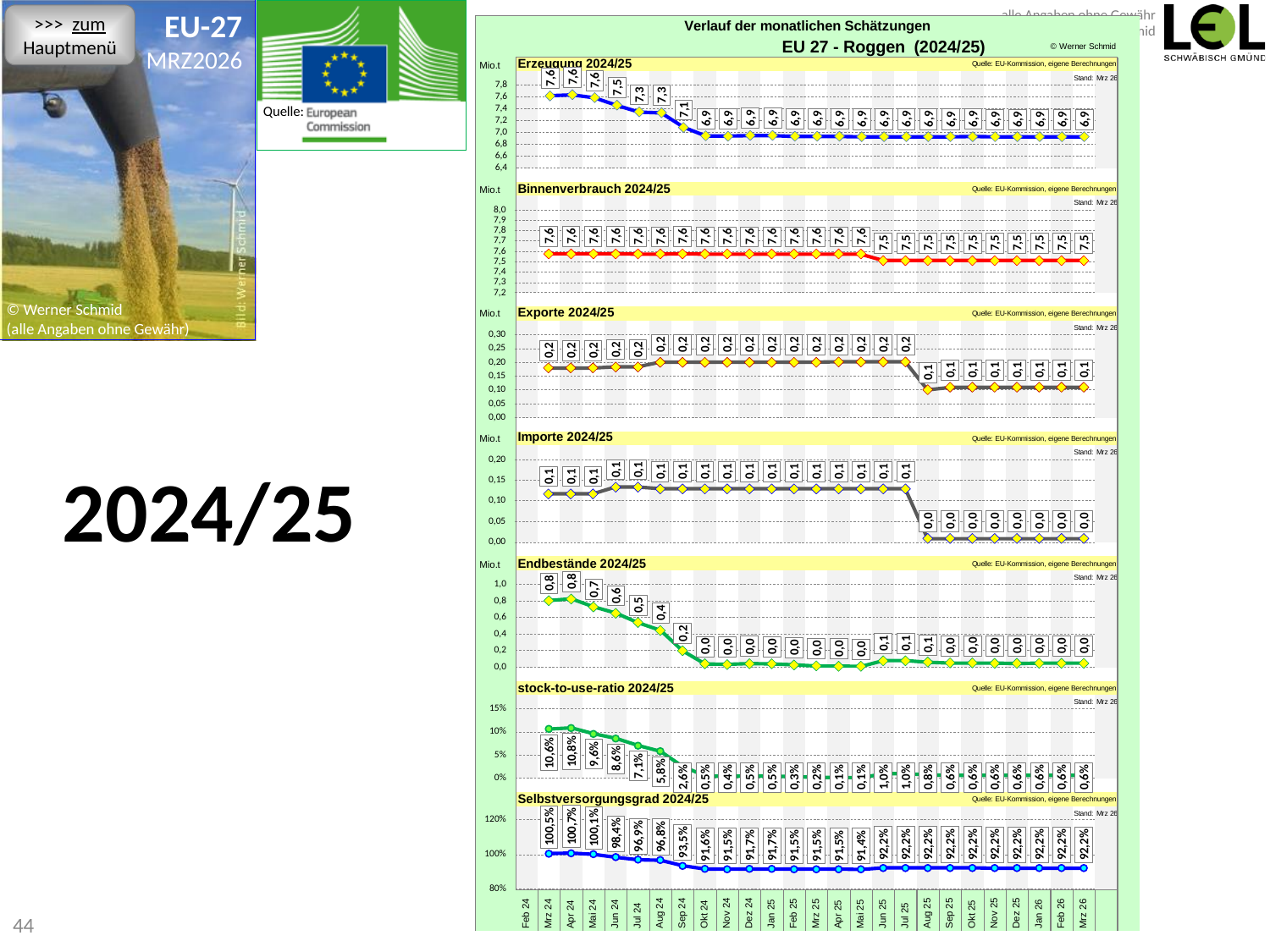
In the 'Importe 2024/25' chart, which is larger: the value at the first point or the value at the last point? the first point In the 'Endbestände 2024/25' chart, what is the highest value shown? 0,8 In the 'Erzeugung 2024/25' chart, what is the value at the last point (Mrz 26)? 6,9 In the 'Erzeugung 2024/25' chart, what is the highest value shown? 7,6 In the 'Exporte 2024/25' chart, what is the value at the last point (Mrz 26)? 0,1 What is the main title printed above the set of charts? Verlauf der monatlichen Schätzungen EU 27 - Roggen (2024/25) In the 'Selbstversorgungsgrad 2024/25' chart, what is the lowest value shown? 91,4% In the 'Erzeugung 2024/25' chart, do the values rise or fall from left to right along the x axis? fall In the 'stock-to-use-ratio 2024/25' chart, what is the highest value shown? 10,8% What kind of chart is used in the 'Erzeugung 2024/25' panel? line chart In the 'Binnenverbrauch 2024/25' chart, what is the value at the last point (Mrz 26)? 7,5 In the 'Selbstversorgungsgrad 2024/25' chart, what is the difference between the highest value (100,7%) and the lowest value (91,4%)? 9,3 percentage points